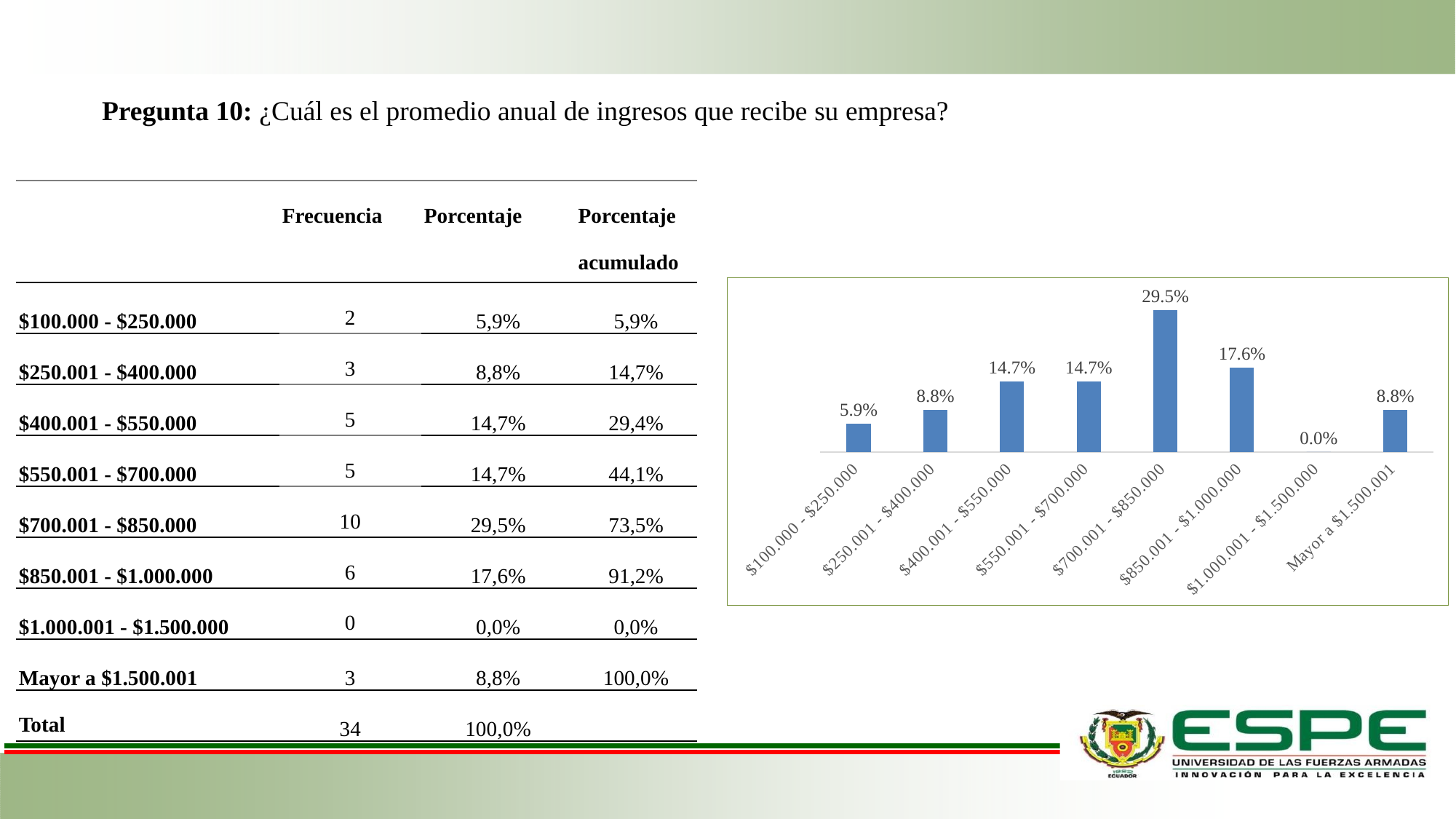
How many categories are plotted in the chart? 8 What is the value shown for the $100.000 - $250.000 category in the chart? 5.9% What kind of chart is shown on the slide? Bar chart What colour are the bars in the chart? Blue Which is larger in the chart: the value for $400.001 - $550.000 or the value for Mayor a $1.500.001? $400.001 - $550.000 What is the difference between the values for $700.001 - $850.000 and $850.001 - $1.000.000 in the chart? 11.9% Which category has the lowest value in the chart? $1.000.001 - $1.500.000 What is the value shown for the $700.001 - $850.000 category in the chart? 29.5% Which category has the highest value in the chart? $700.001 - $850.000 What is the value shown for the $850.001 - $1.000.000 category in the chart? 17.6% What is the value shown for the $1.000.001 - $1.500.000 category in the chart? 0.0% What is the difference between the values for $250.001 - $400.000 and $100.000 - $250.000 in the chart? 2.9%